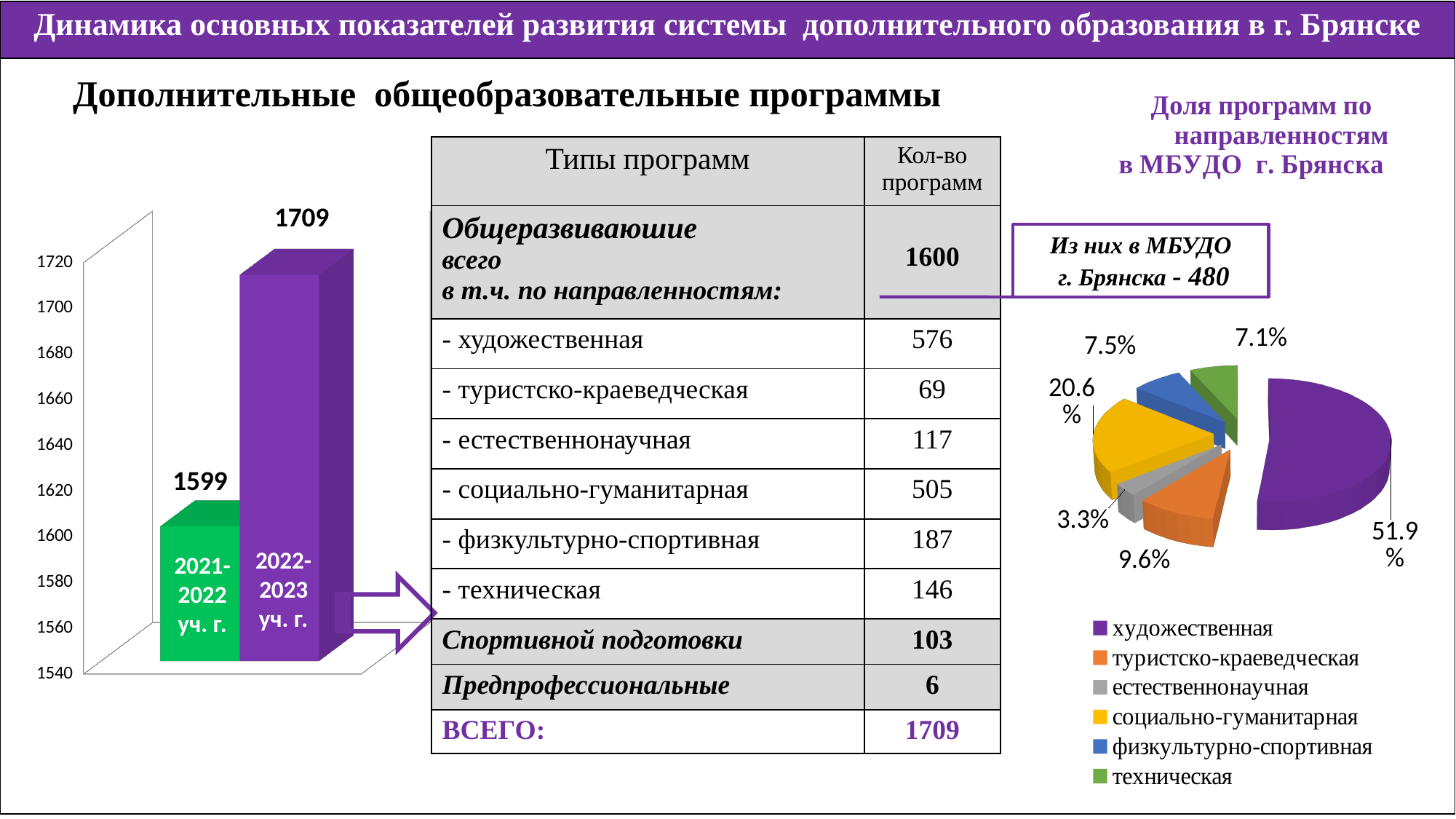
On the bar chart on the left, by how much does the value for 2022-2023 уч. г. exceed the value for 2021-2022 уч. г.? 110 How many categories does the legend of the pie chart 'Доля программ по направленностям в МБУДО г. Брянска' list? 6 On the bar chart on the left, what is the value for 2021-2022 уч. г.? 1599 On the pie chart 'Доля программ по направленностям в МБУДО г. Брянска', which is larger: туристско-краеведческая or физкультурно-спортивная? туристско-краеведческая On the pie chart 'Доля программ по направленностям в МБУДО г. Брянска', what share does социально-гуманитарная have? 20.6% On the pie chart 'Доля программ по направленностям в МБУДО г. Брянска', which category has the smallest share? естественнонаучная What kind of chart is the chart on the left of the slide? bar chart On the pie chart 'Доля программ по направленностям в МБУДО г. Брянска', which category has the largest share? художественная On the bar chart on the left, how many bars are plotted? 2 On the bar chart on the left, do the values rise or fall from 2021-2022 уч. г. to 2022-2023 уч. г.? rise On the bar chart on the left, what is the value for 2022-2023 уч. г.? 1709 On the pie chart 'Доля программ по направленностям в МБУДО г. Брянска', what share does художественная have? 51.9%